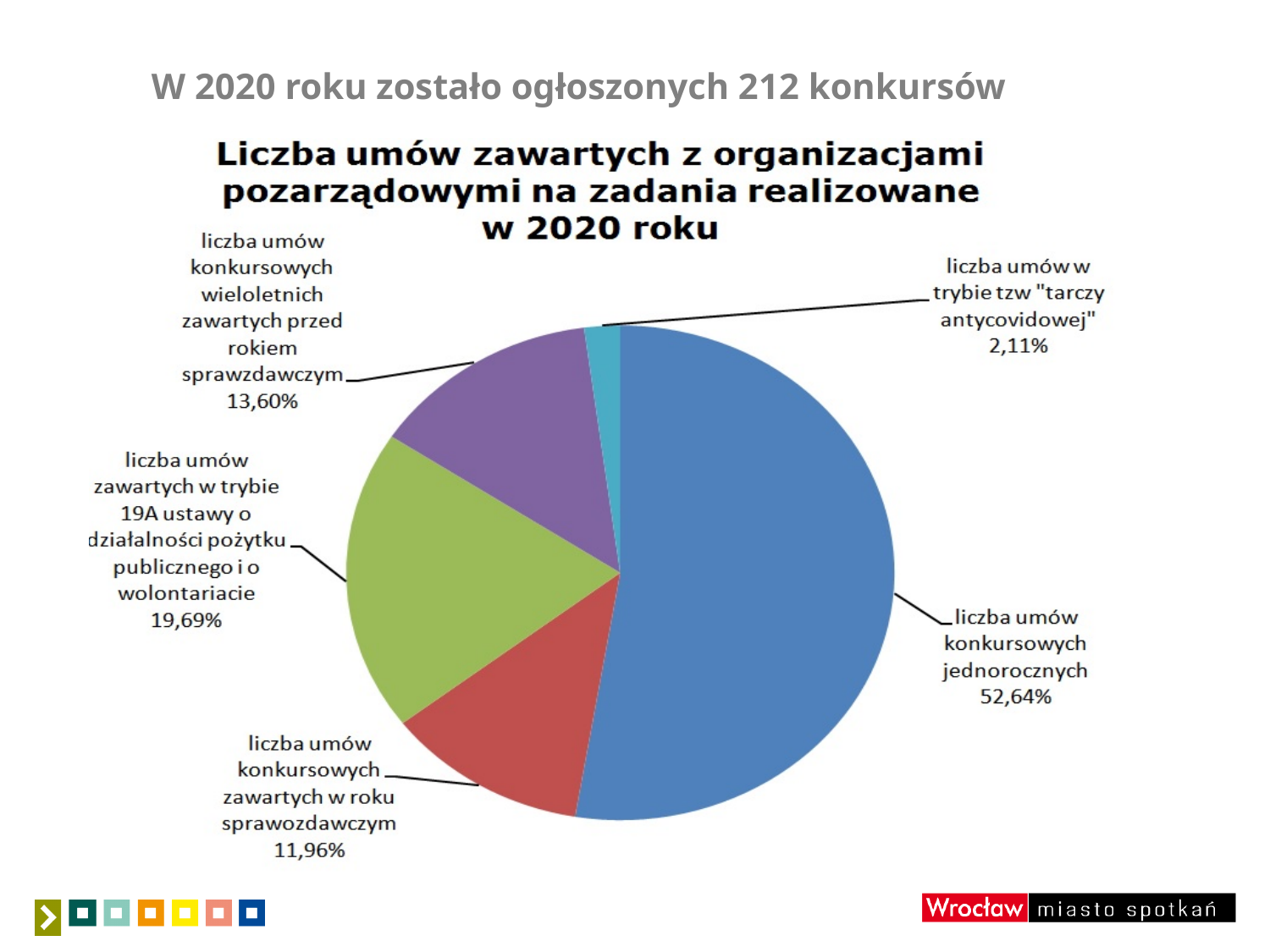
What is the difference in percentage points between 'liczba umów konkursowych jednorocznych' and 'liczba umów zawartych w trybie 19A ustawy o działalności pożytku publicznego i o wolontariacie'? 32,95 What share of the pie is 'liczba umów konkursowych zawartych w roku sprawozdawczym'? 11,96% What kind of chart is shown on the slide? pie chart How many slices does the pie chart have? 5 What is the title of the pie chart? Liczba umów zawartych z organizacjami pozarządowymi na zadania realizowane w 2020 roku What share of the pie is 'liczba umów zawartych w trybie 19A ustawy o działalności pożytku publicznego i o wolontariacie'? 19,69% Which category has the smallest slice of the pie? liczba umów w trybie tzw "tarczy antycovidowej" What share of the pie is 'liczba umów konkursowych jednorocznych'? 52,64% What share of the pie is 'liczba umów w trybie tzw "tarczy antycovidowej"'? 2,11% What share of the pie is 'liczba umów konkursowych wieloletnich zawartych przed rokiem sprawzdawczym'? 13,60% Which category has the largest slice of the pie? liczba umów konkursowych jednorocznych Which is larger: the share for 'liczba umów konkursowych wieloletnich zawartych przed rokiem sprawzdawczym' or for 'liczba umów konkursowych zawartych w roku sprawozdawczym'? liczba umów konkursowych wieloletnich zawartych przed rokiem sprawzdawczym